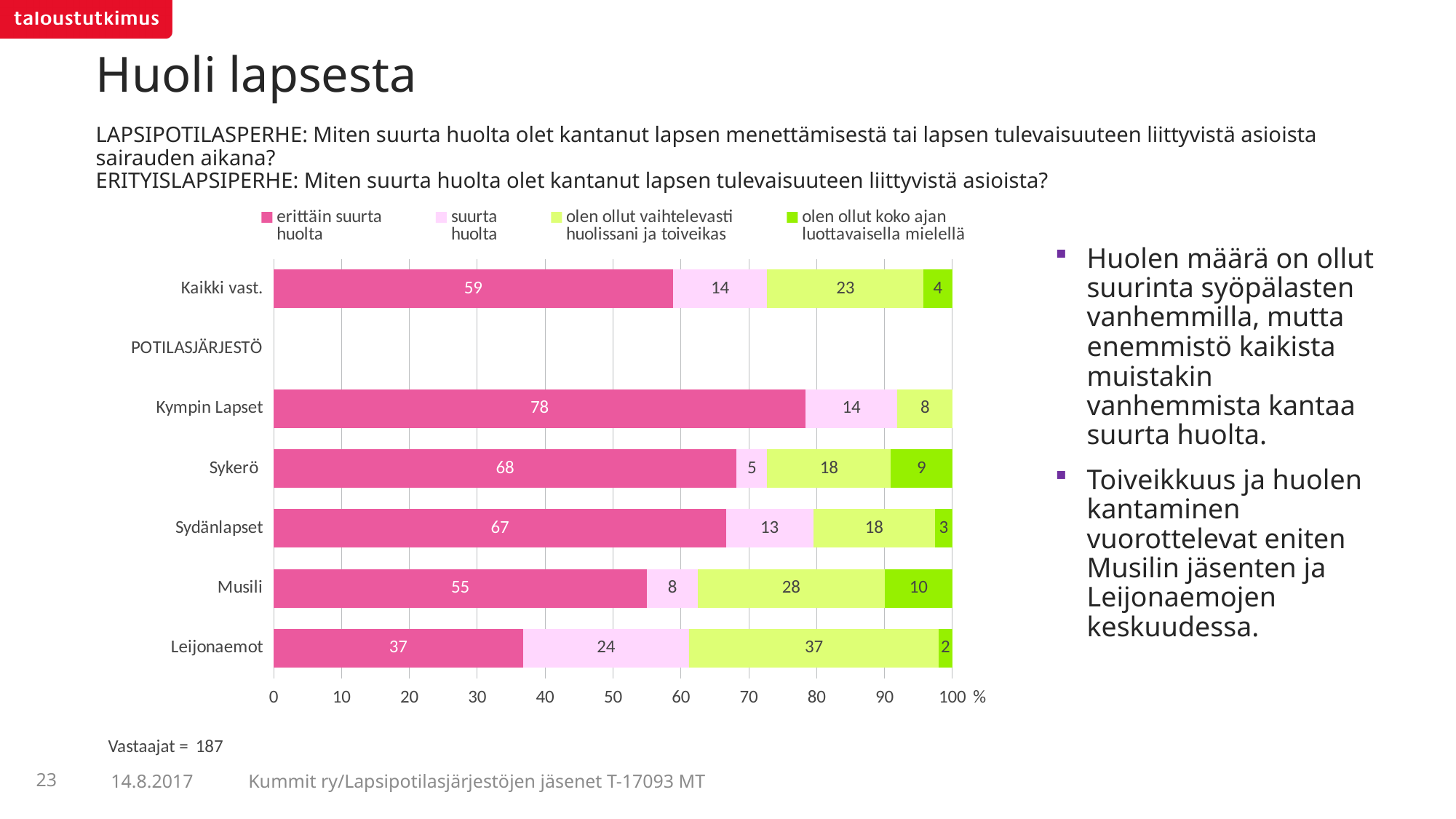
What is the value of 'olen ollut koko ajan luottavaisella mielellä' for Kaikki vast.? 4 What is the value of 'suurta huolta' for Leijonaemot? 24 Which group has the highest value for 'olen ollut vaihtelevasti huolissani ja toiveikas'? Leijonaemot Which group has the highest value for 'erittäin suurta huolta'? Kympin Lapset What is the difference between the 'erittäin suurta huolta' values for Sykerö and Musili? 13 Which group has the lowest value for 'erittäin suurta huolta'? Leijonaemot What is the value of 'olen ollut vaihtelevasti huolissani ja toiveikas' for Musili? 28 What kind of chart is shown on the slide? bar chart How many series does the legend list? 4 Which is larger: the 'olen ollut koko ajan luottavaisella mielellä' value for Musili or for Sydänlapset? Musili What is the number of respondents (Vastaajat) shown below the chart? 187 What is the value of 'erittäin suurta huolta' for Kympin Lapset? 78